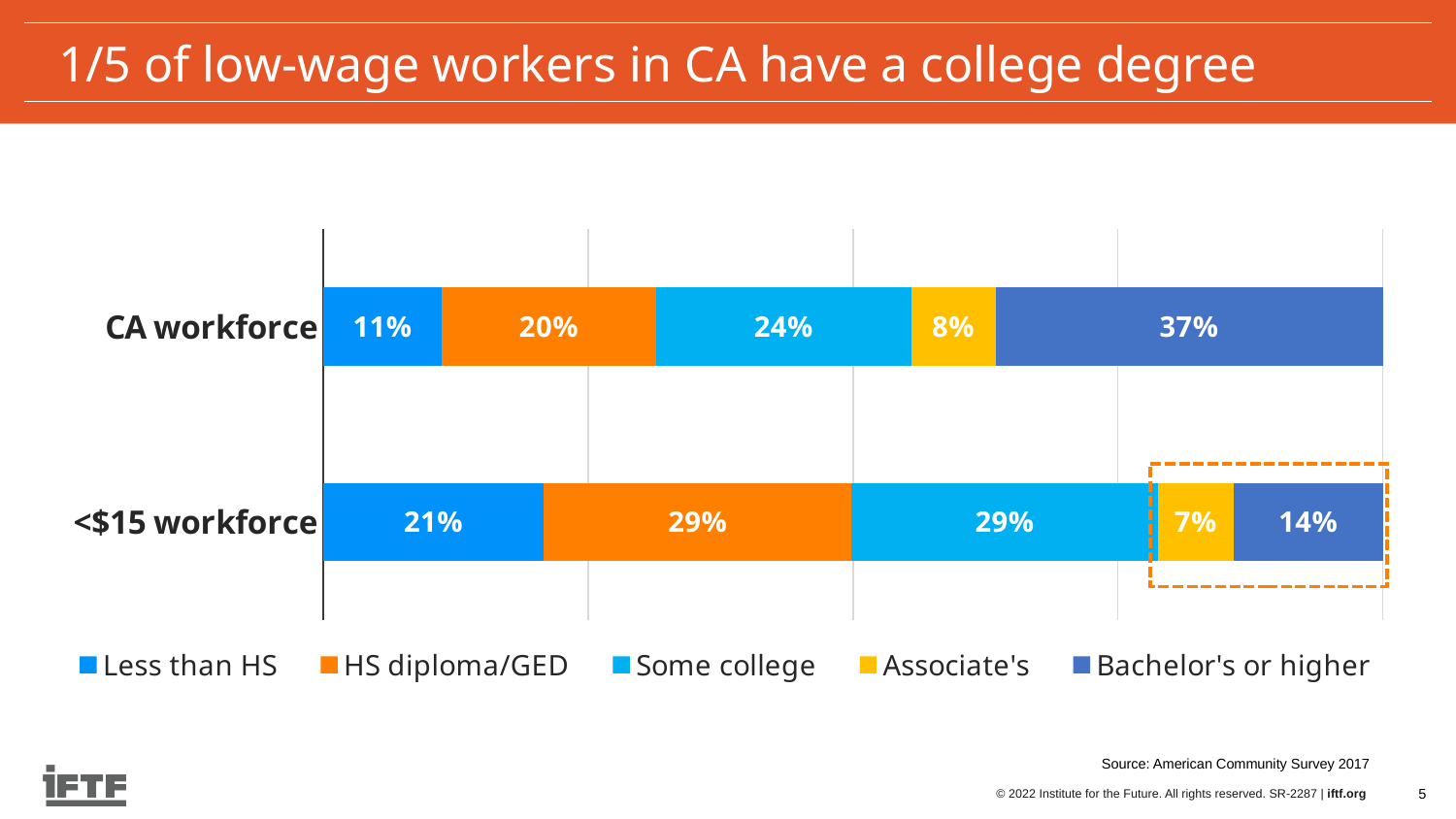
What is the combined share of Associate's and Bachelor's or higher in the <$15 workforce? 21% What is the difference between the Bachelor's or higher share of the CA workforce and that of the <$15 workforce? 23% Which education level makes up the largest share of the CA workforce bar? Bachelor's or higher What share of the <$15 workforce has an Associate's degree? 7% Which group has a larger HS diploma/GED share, the CA workforce or the <$15 workforce? <$15 workforce What kind of chart is shown on the slide? Stacked bar chart How many workforce categories are shown on the chart? 2 How many series does the legend list? 5 What share of the CA workforce has a Bachelor's or higher? 37% What share of the <$15 workforce has less than HS education? 21% Which education level makes up the smallest share of the <$15 workforce bar? Associate's What share of the CA workforce has some college? 24%